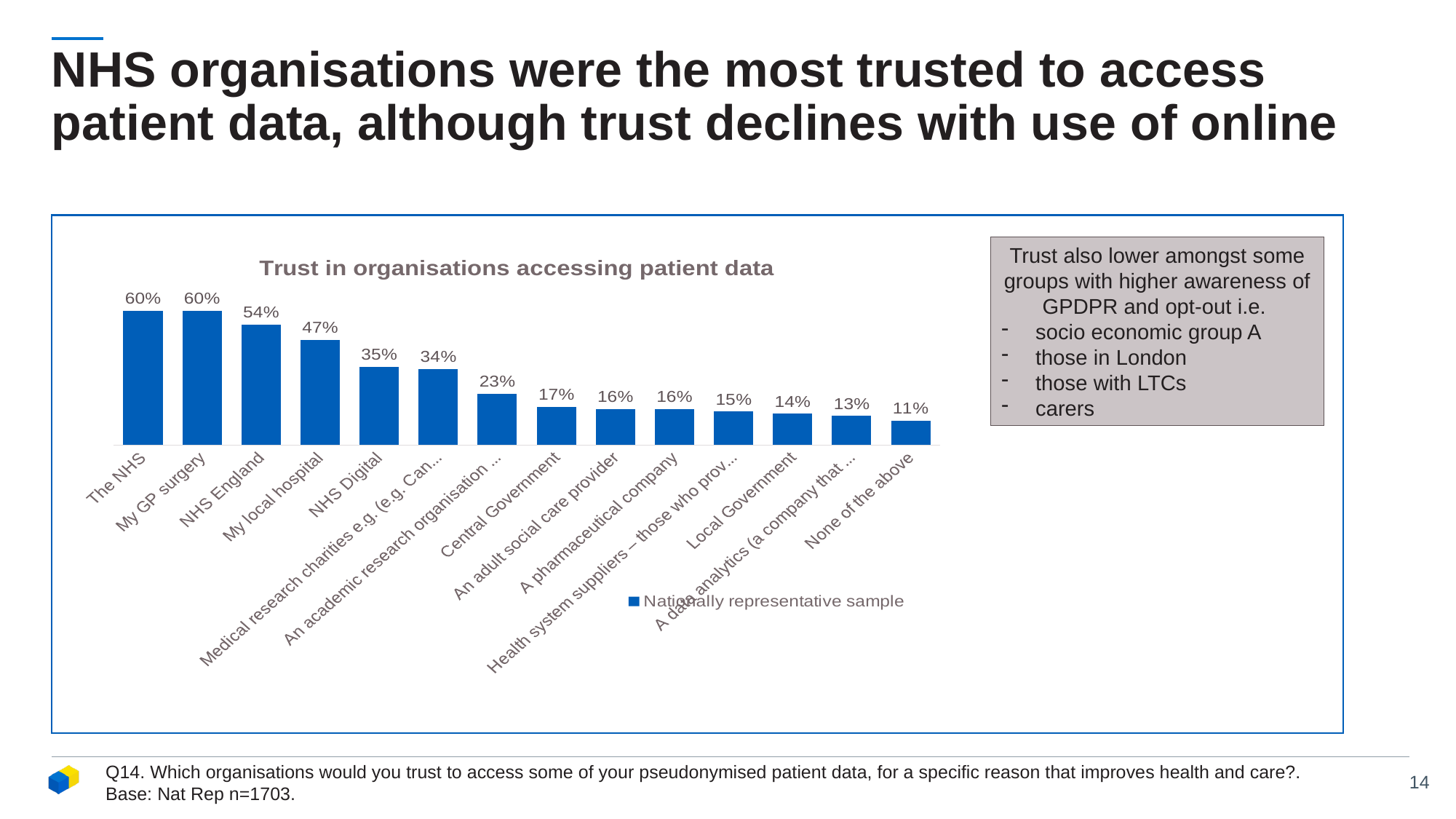
What is the difference between the values for My local hospital and Central Government? 30% What is the value for Local Government? 14% What is the value for My local hospital? 47% Which is larger, the value for NHS Digital or the value for A pharmaceutical company? NHS Digital What is the difference between the values for NHS England and NHS Digital? 19% What kind of chart is shown? Bar chart How many series does the legend list? 1 What is the value for Central Government? 17% What is the value for NHS England? 54% How many categories are shown on the x axis? 14 What is the title of the chart? Trust in organisations accessing patient data Which category has the lowest value? None of the above